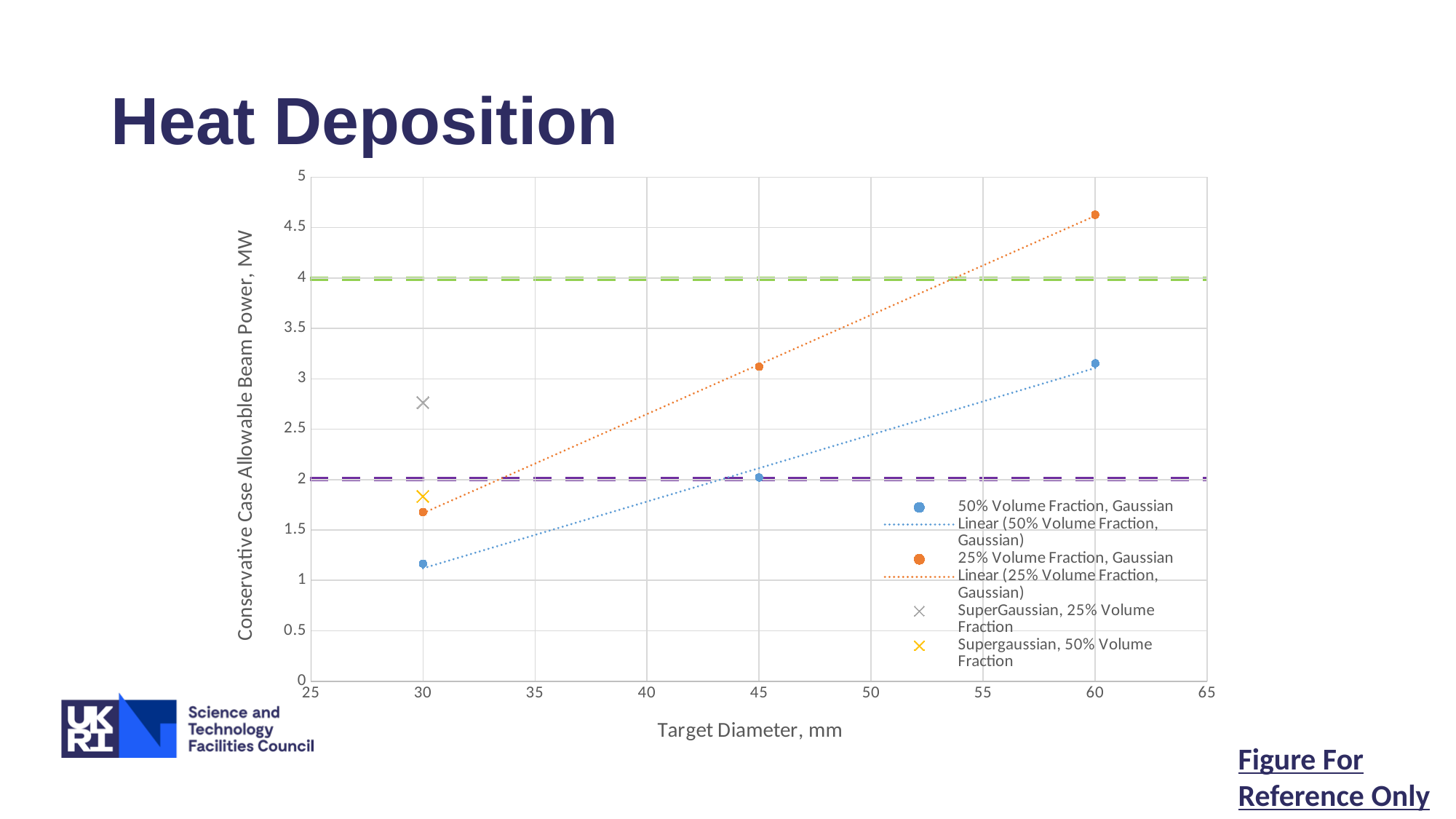
At a target diameter of 30 mm, which is higher: SuperGaussian, 25% Volume Fraction or Supergaussian, 50% Volume Fraction? SuperGaussian, 25% Volume Fraction Is the value for 50% Volume Fraction, Gaussian at a target diameter of 30 mm greater or less than 1.5? less How many data points are plotted for the 25% Volume Fraction, Gaussian series? 3 How many entries does the chart legend list? 6 Do the values for 50% Volume Fraction, Gaussian rise or fall as target diameter increases? rise At a target diameter of 60 mm, which is higher: 25% Volume Fraction, Gaussian or 50% Volume Fraction, Gaussian? 25% Volume Fraction, Gaussian Is the value for 25% Volume Fraction, Gaussian at a target diameter of 60 mm greater or less than 4.5? greater Is the value for SuperGaussian, 25% Volume Fraction at a target diameter of 30 mm greater or less than 2.5? greater What is the title of the y axis? Conservative Case Allowable Beam Power, MW What kind of chart is shown on the slide? scatter chart What is the title of the x axis? Target Diameter, mm